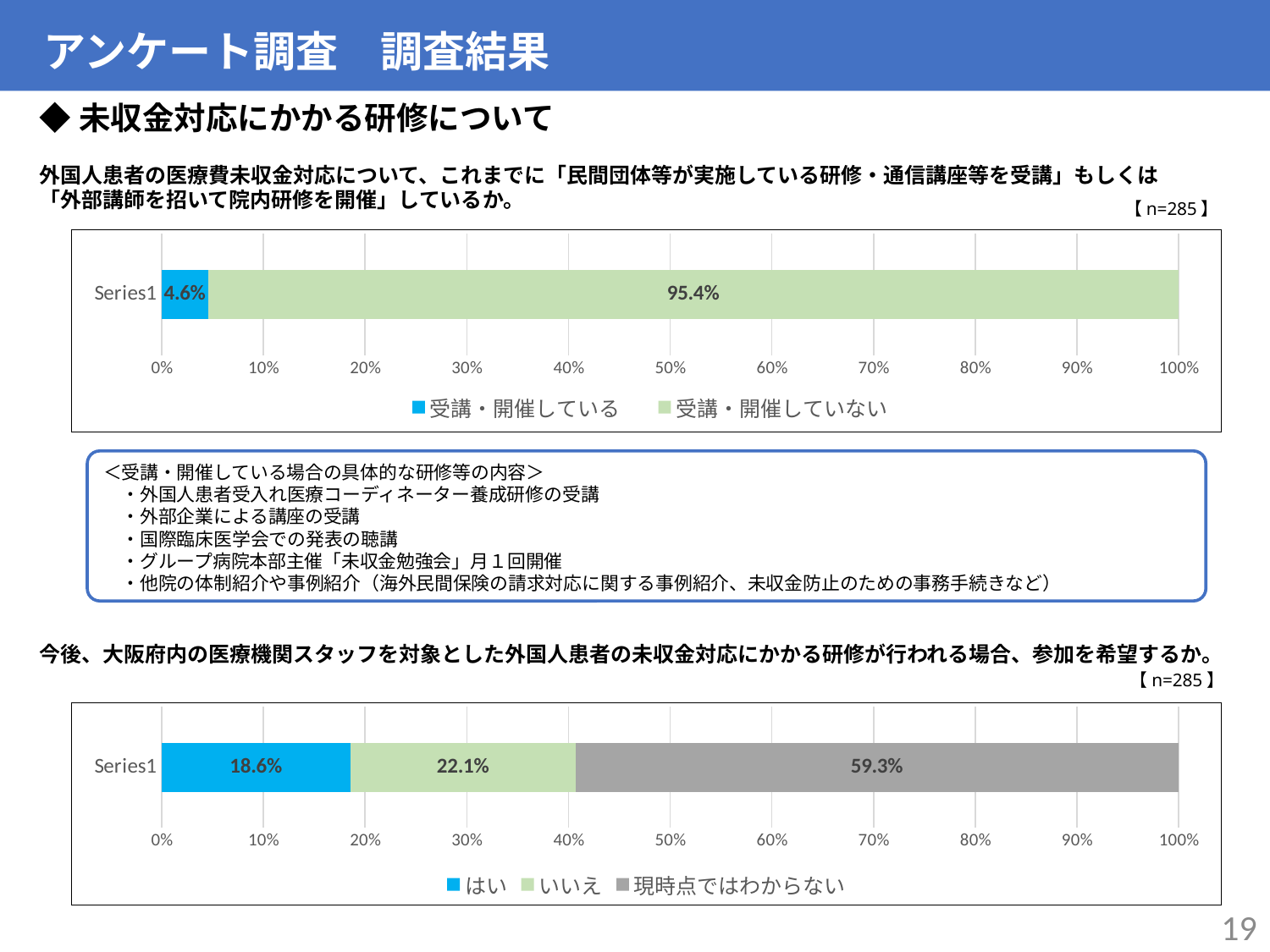
In the bottom chart, what percentage is shown for はい? 18.6% In the bottom chart, which is larger, はい or いいえ? いいえ In the top chart, which legend category has the larger share? 受講・開催していない In the bottom chart, how many series does the legend list? 3 In the bottom chart, what percentage is shown for いいえ? 22.1% In the top chart, what is the difference between 受講・開催していない and 受講・開催している? 90.8% In the top chart, what percentage is shown for 受講・開催している? 4.6% In the bottom chart, what percentage is shown for 現時点ではわからない? 59.3% What type of chart is the bottom chart? Stacked bar chart In the bottom chart, which legend category has the smallest share? はい In the top chart, what percentage is shown for 受講・開催していない? 95.4% In the top chart, how many series does the legend list? 2